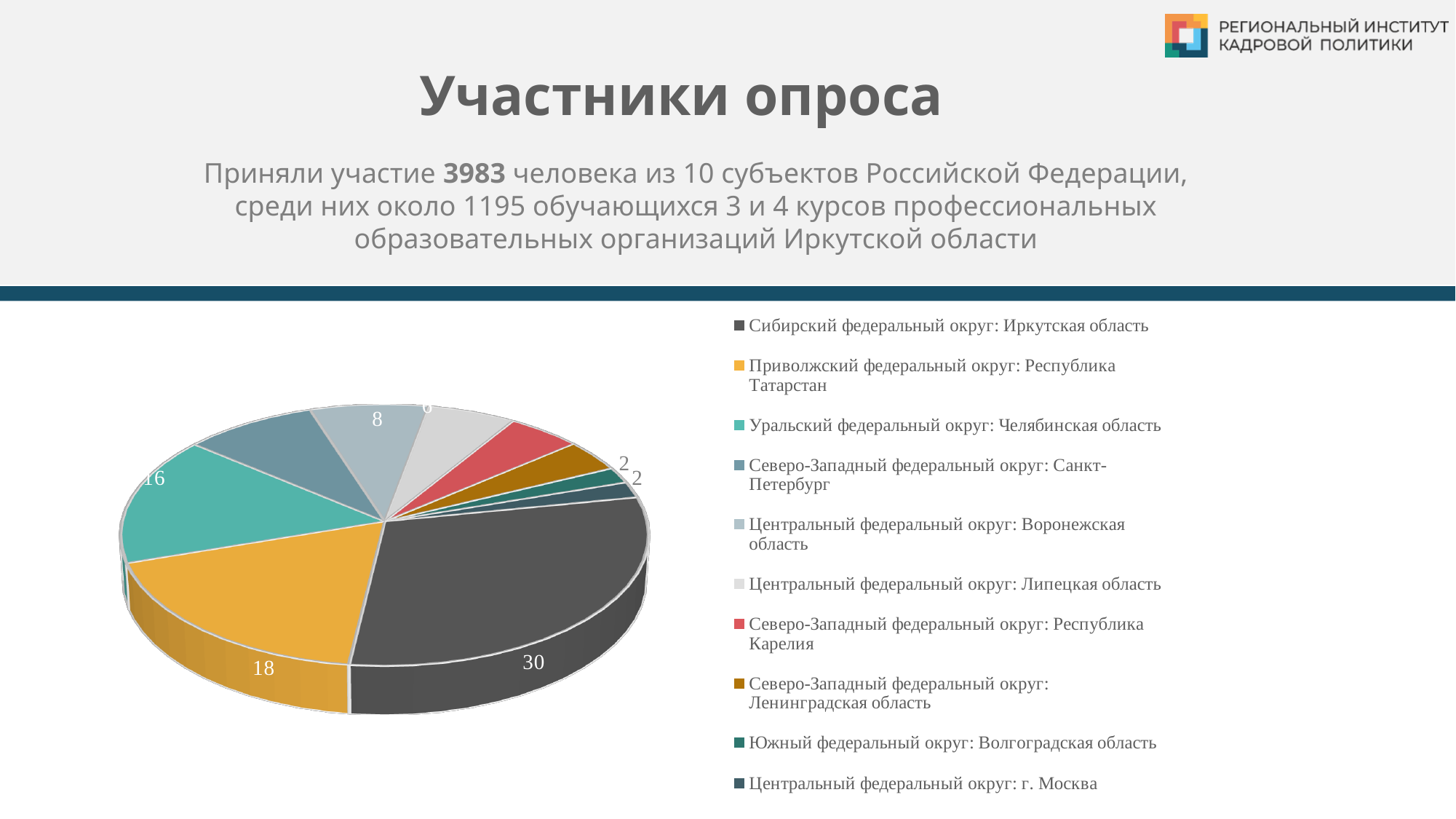
What is the difference between the values for Иркутская область and Республика Татарстан? 12 What is the value for Центральный федеральный округ: Воронежская область? 8 Which is larger: the value for Челябинская область or the value for Воронежская область? Челябинская область Which is larger: the value for Иркутская область or the value for Республика Татарстан? Иркутская область What kind of chart is shown on the slide? pie chart What is the difference between the values for Республика Татарстан and Челябинская область? 2 What colour is the slice for Сибирский федеральный округ: Иркутская область? dark gray How many categories does the legend list? 10 What is the value for Уральский федеральный округ: Челябинская область? 16 What is the value for Сибирский федеральный округ: Иркутская область? 30 Which category has the largest slice of the pie? Сибирский федеральный округ: Иркутская область What is the value for Приволжский федеральный округ: Республика Татарстан? 18